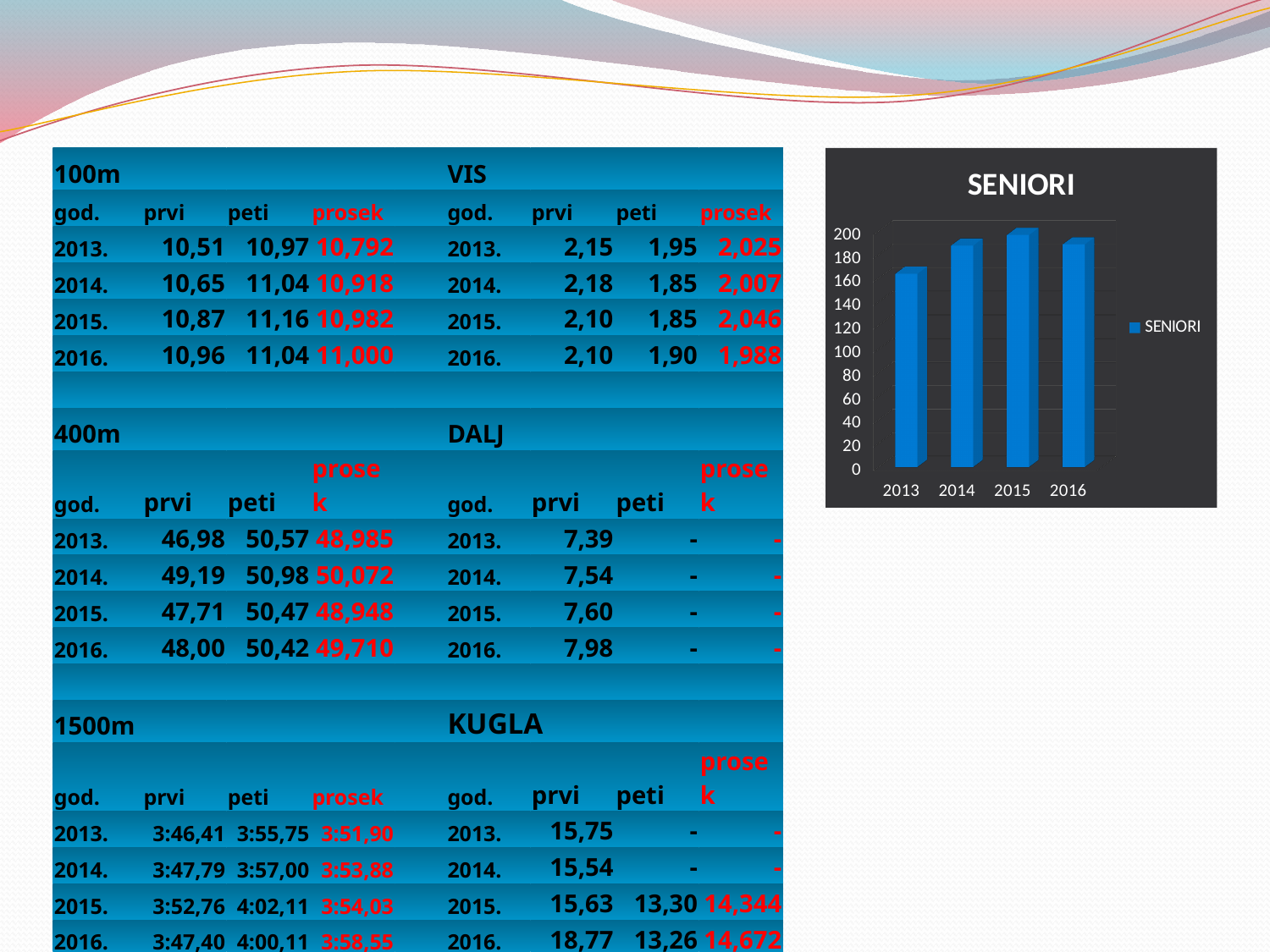
What is the title of the bar chart on the slide? SENIORI In the SENIORI chart, is the value for 2013 greater or less than 180? less In the SENIORI chart, is the value for 2014 greater or less than 160? greater In the SENIORI chart, which is larger, the value for 2013 or the value for 2016? 2016 What kind of chart is the SENIORI chart? bar chart How many years are shown on the x axis of the SENIORI chart? 4 In the SENIORI chart, is the value for 2013 greater or less than 140? greater How many series does the legend of the SENIORI chart list? 1 In the SENIORI chart, which is larger, the value for 2013 or the value for 2015? 2015 What is the name of the series shown in the legend of the SENIORI chart? SENIORI In the SENIORI chart, which year has the lowest value? 2013